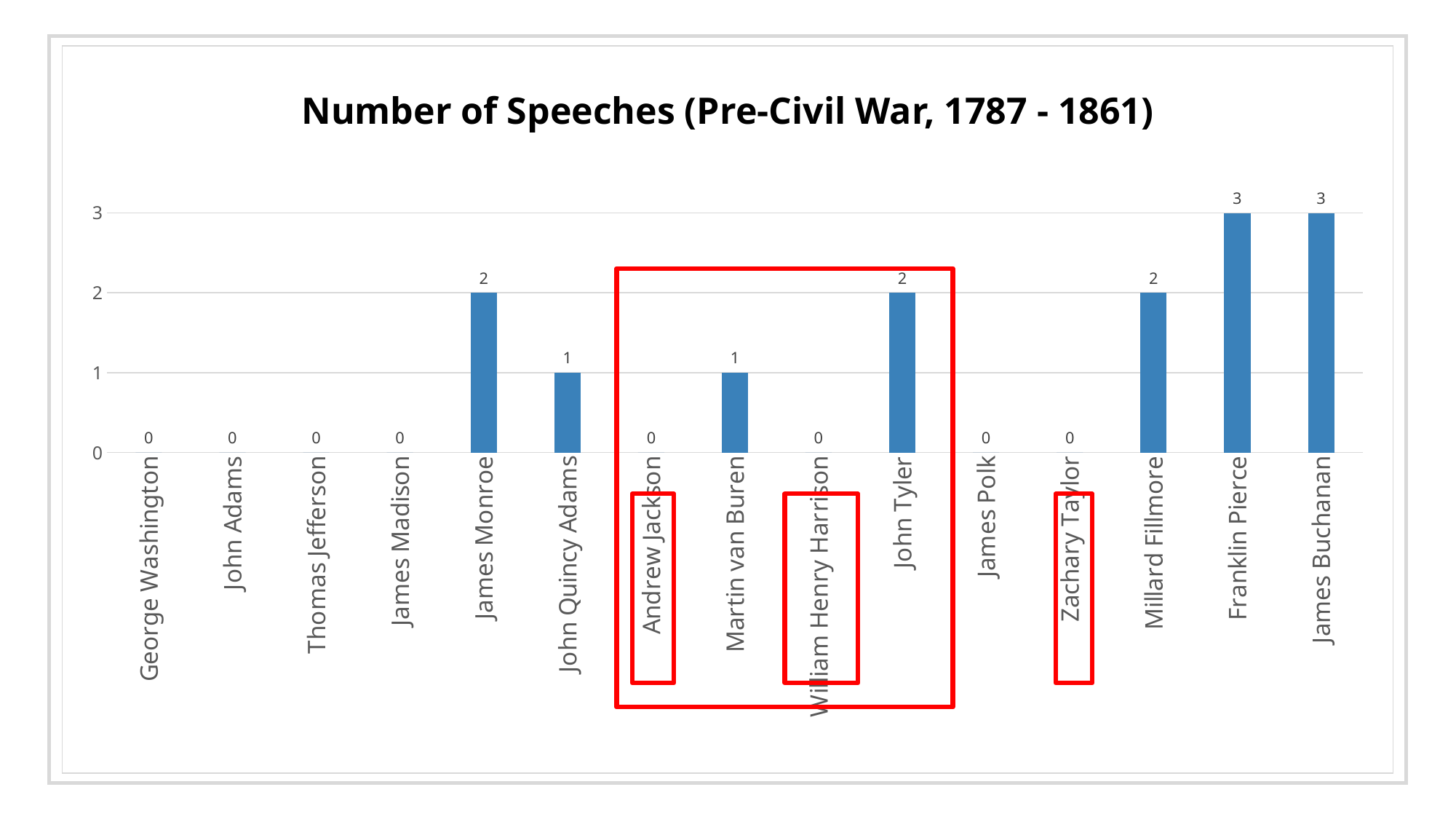
What is the number of speeches for Franklin Pierce? 3 What type of chart is shown on the slide? bar chart Who has more speeches, Millard Fillmore or John Quincy Adams? Millard Fillmore What is the highest number of speeches shown for any president on the chart? 3 How many presidents on the chart have 0 speeches? 8 What is the number of speeches for Martin van Buren? 1 What is the number of speeches for James Monroe? 2 How many presidents (categories) are shown on the x axis? 15 What is the total number of speeches for Andrew Jackson, Martin van Buren, William Henry Harrison and John Tyler combined? 3 What is the difference in number of speeches between James Buchanan and John Tyler? 1 What is the number of speeches for Zachary Taylor? 0 What is the title of the chart? Number of Speeches (Pre-Civil War, 1787 - 1861)